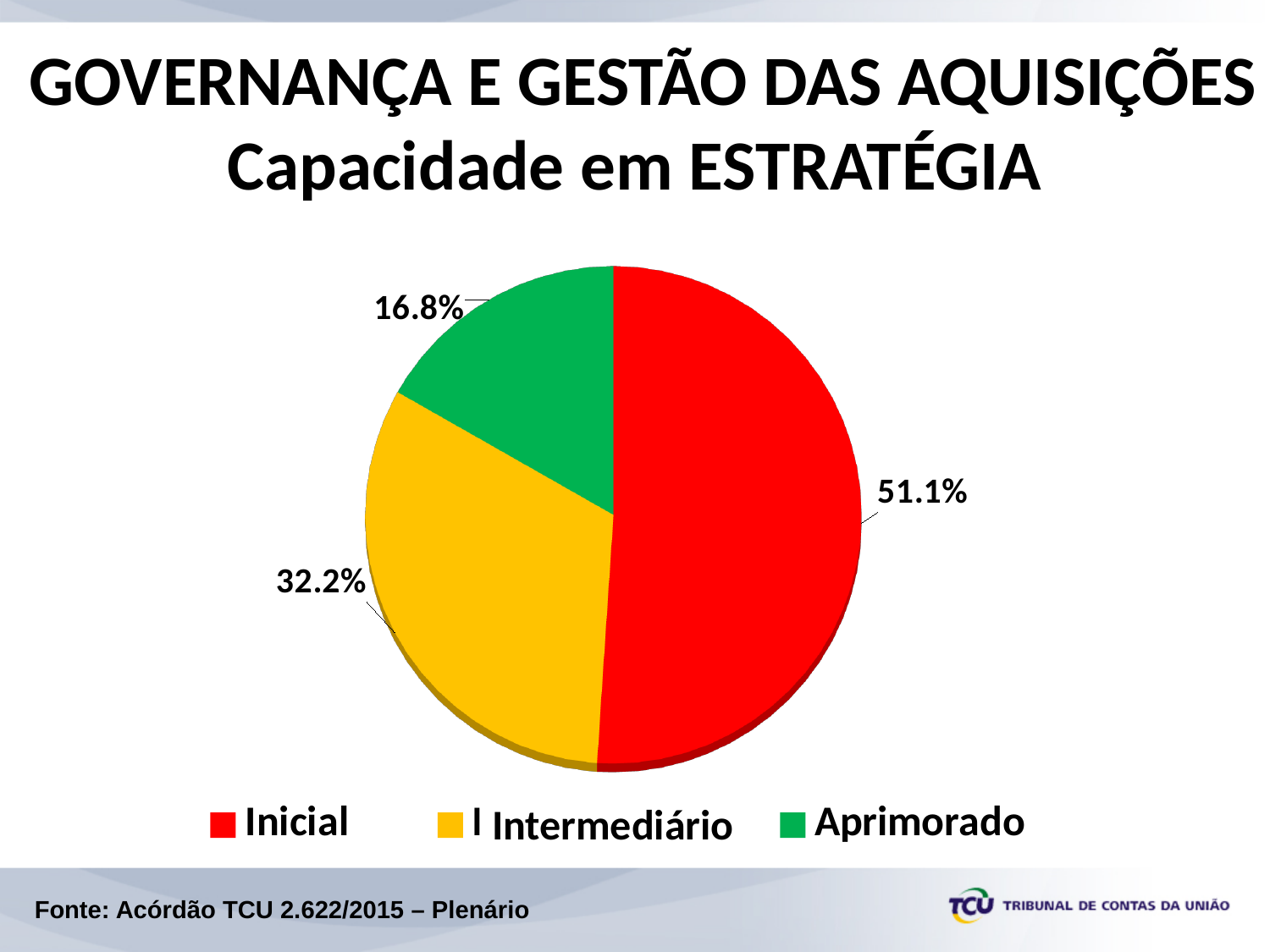
What percentage of the pie is labelled Inicial? 51.1% What colour is the Aprimorado slice? green What kind of chart is shown on the slide? pie chart What is the subtitle of the chart below 'GOVERNANÇA E GESTÃO DAS AQUISIÇÕES'? Capacidade em ESTRATÉGIA What percentage of the pie is labelled Aprimorado? 16.8% Which category has the smallest slice of the pie? Aprimorado How many slices does the pie chart have? 3 What is the difference in percentage points between the Inicial and Intermediário slices? 18.9 Which slice is larger, Intermediário or Aprimorado? Intermediário Which category has the largest slice of the pie? Inicial What is the difference in percentage points between the Intermediário and Aprimorado slices? 15.4 What percentage of the pie is labelled Intermediário? 32.2%